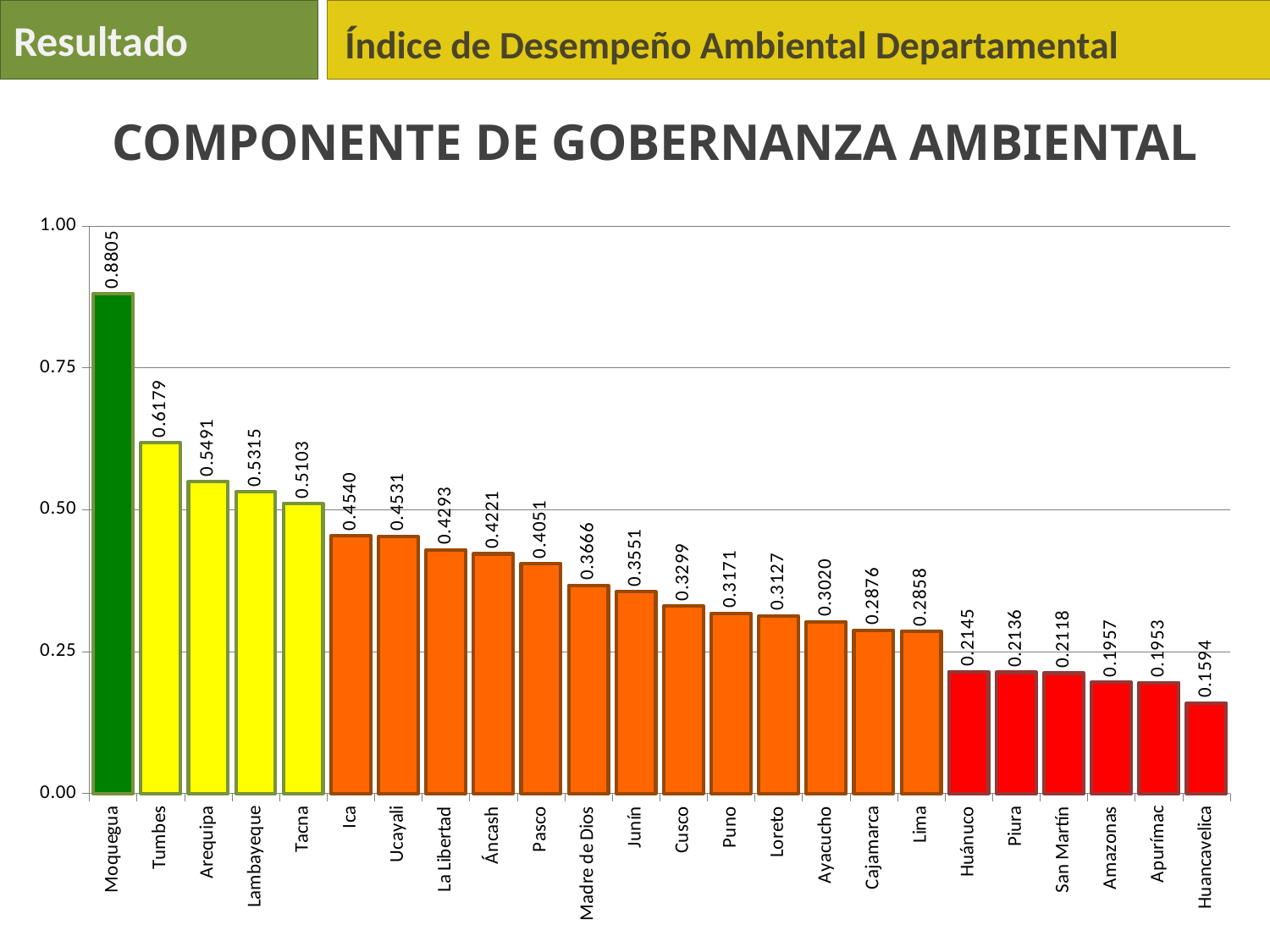
Which department has the highest value? Moquegua Which has a larger value, Tacna or Cusco? Tacna Is the value for Arequipa greater or less than 0.50? greater What kind of chart is shown on the slide? bar chart What is the value for Huancavelica? 0.1594 What is the value for Moquegua? 0.8805 Do the values rise or fall from left to right along the x axis? fall How many departments are shown on the chart? 24 What is the value for Lima? 0.2858 What is the value for Madre de Dios? 0.3666 What is the difference between the values for Moquegua and Tumbes? 0.2626 Which department has the lowest value? Huancavelica